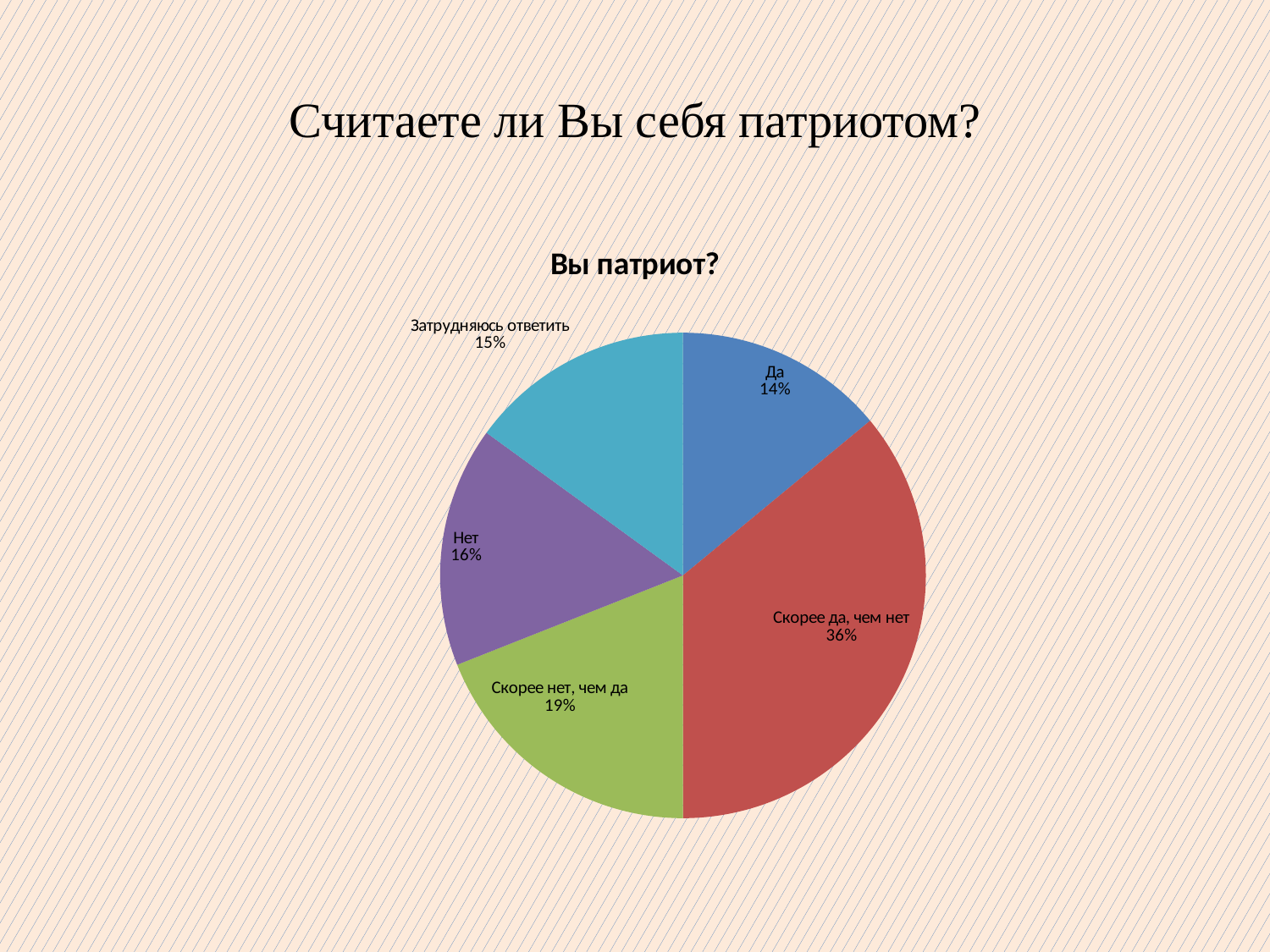
What colour is the "Скорее нет, чем да" slice? green What is the value for "Нет"? 16% What is the value for "Затрудняюсь ответить"? 15% What is the chart's title? Вы патриот? What kind of chart is shown on the slide? pie chart Which category has the largest slice? Скорее да, чем нет What is the value for "Да"? 14% What share of the pie is "Скорее да, чем нет"? 36% Which category has the smallest slice? Да Which is larger, "Нет" or "Затрудняюсь ответить"? Нет What is the difference between "Скорее да, чем нет" and "Скорее нет, чем да"? 17% How many slices does the pie chart have? 5